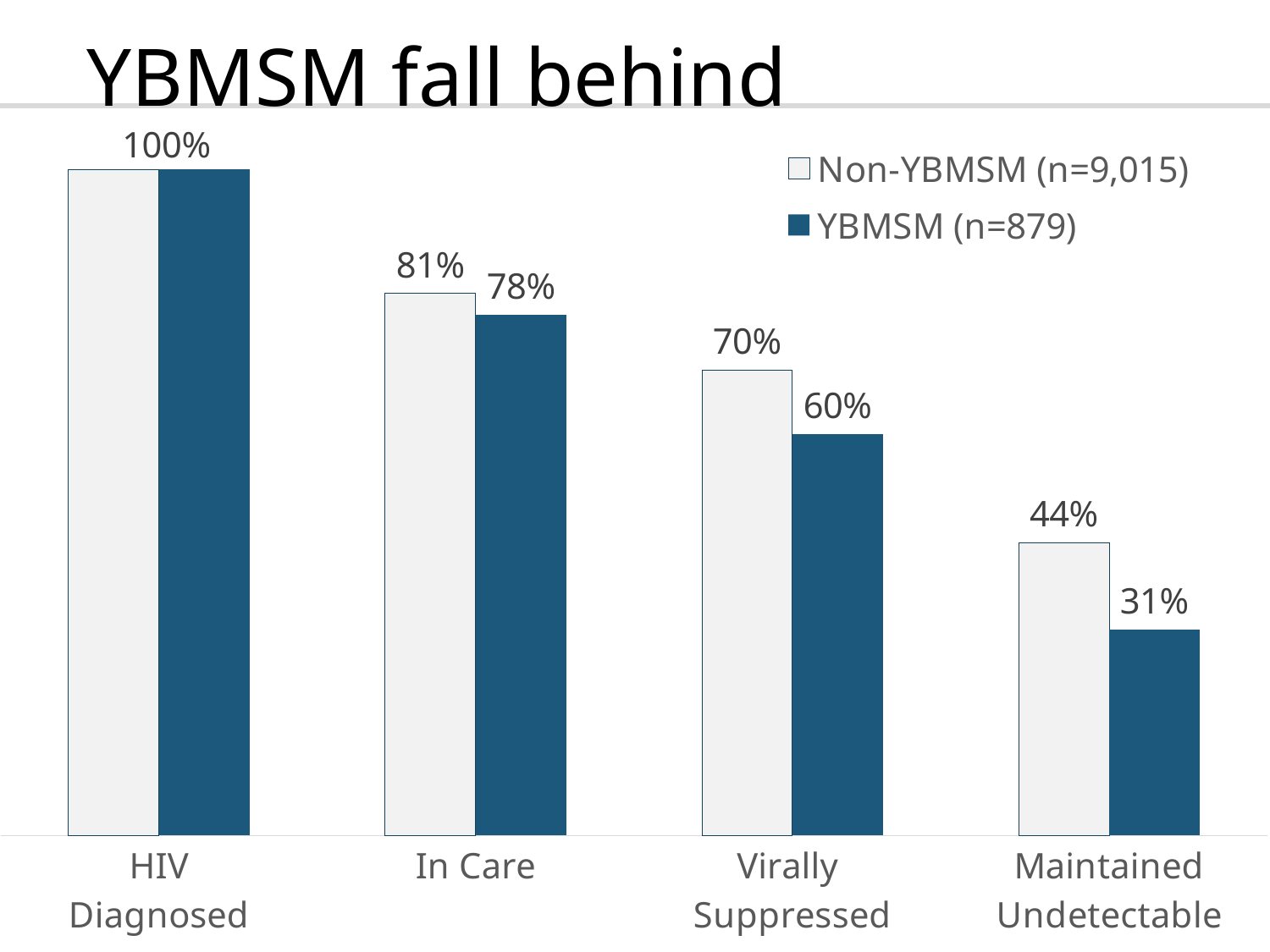
Which category has the lowest value for YBMSM? Maintained Undetectable Do the YBMSM values rise or fall from HIV Diagnosed to Maintained Undetectable? Fall What is the value for YBMSM in the In Care category? 78% What kind of chart is shown on the slide? Bar chart What is the value for Non-YBMSM in the Maintained Undetectable category? 44% What is the difference between the Non-YBMSM and YBMSM values in the Maintained Undetectable category? 13% What is the difference between the Non-YBMSM and YBMSM values in the Virally Suppressed category? 10% How many series does the legend list? 2 What is the value for YBMSM in the Maintained Undetectable category? 31% What is the value for Non-YBMSM in the Virally Suppressed category? 70% Which is larger in the In Care category, the Non-YBMSM value or the YBMSM value? Non-YBMSM How many categories are shown on the x axis? 4